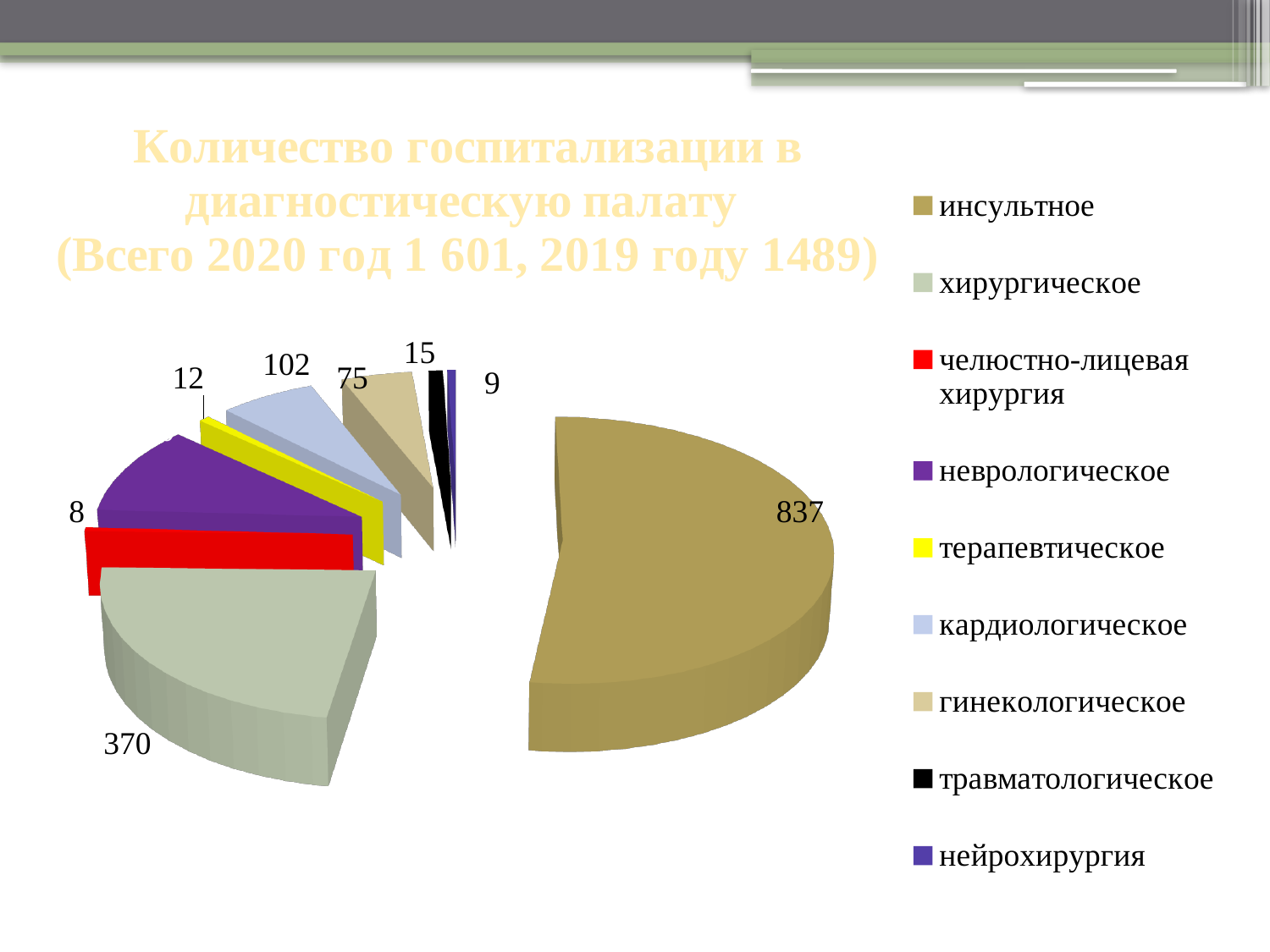
What is the value for гинекологическое? 75 Which category has the smallest value shown on the chart? челюстно-лицевая хирургия How many categories does the legend of the pie chart list? 9 What colour is the slice for челюстно-лицевая хирургия? red What is the value for кардиологическое? 102 What is the value for инсультное? 837 What is the value for травматологическое? 15 What is the value for хирургическое? 370 Which is larger, the value for кардиологическое or the value for гинекологическое? кардиологическое Which category has the largest slice of the pie? инсультное What is the difference between the values for инсультное and хирургическое? 467 What kind of chart is shown on the slide? pie chart